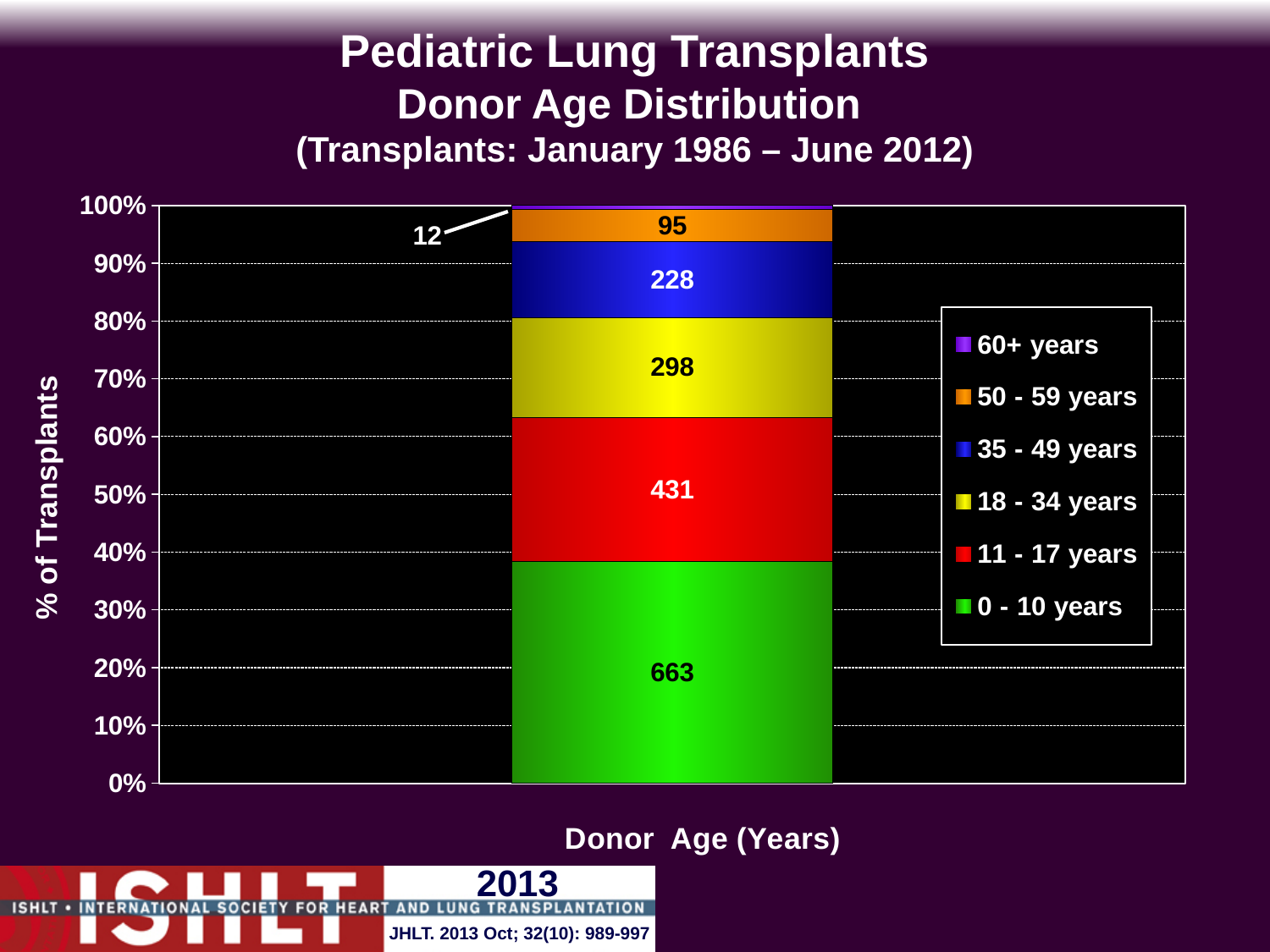
Which donor age group has the highest number of transplants? 0 - 10 years What is the difference between the number of transplants for donors aged 18 - 34 years and 35 - 49 years? 70 What is the number of transplants for donors aged 35 - 49 years? 228 What is the number of transplants for donors aged 60+ years? 12 What is the total number of transplants across all donor age groups in the bar? 1727 Is the share of transplants for donors aged 0 - 10 years greater or less than 40%? less What is the number of transplants for donors aged 11 - 17 years? 431 What kind of chart is shown on the slide? Stacked bar chart Which has more transplants: donors aged 11 - 17 years or donors aged 50 - 59 years? 11 - 17 years How many donor age groups does the legend list? 6 What is the number of transplants for donors aged 0 - 10 years? 663 Which donor age group has the lowest number of transplants? 60+ years